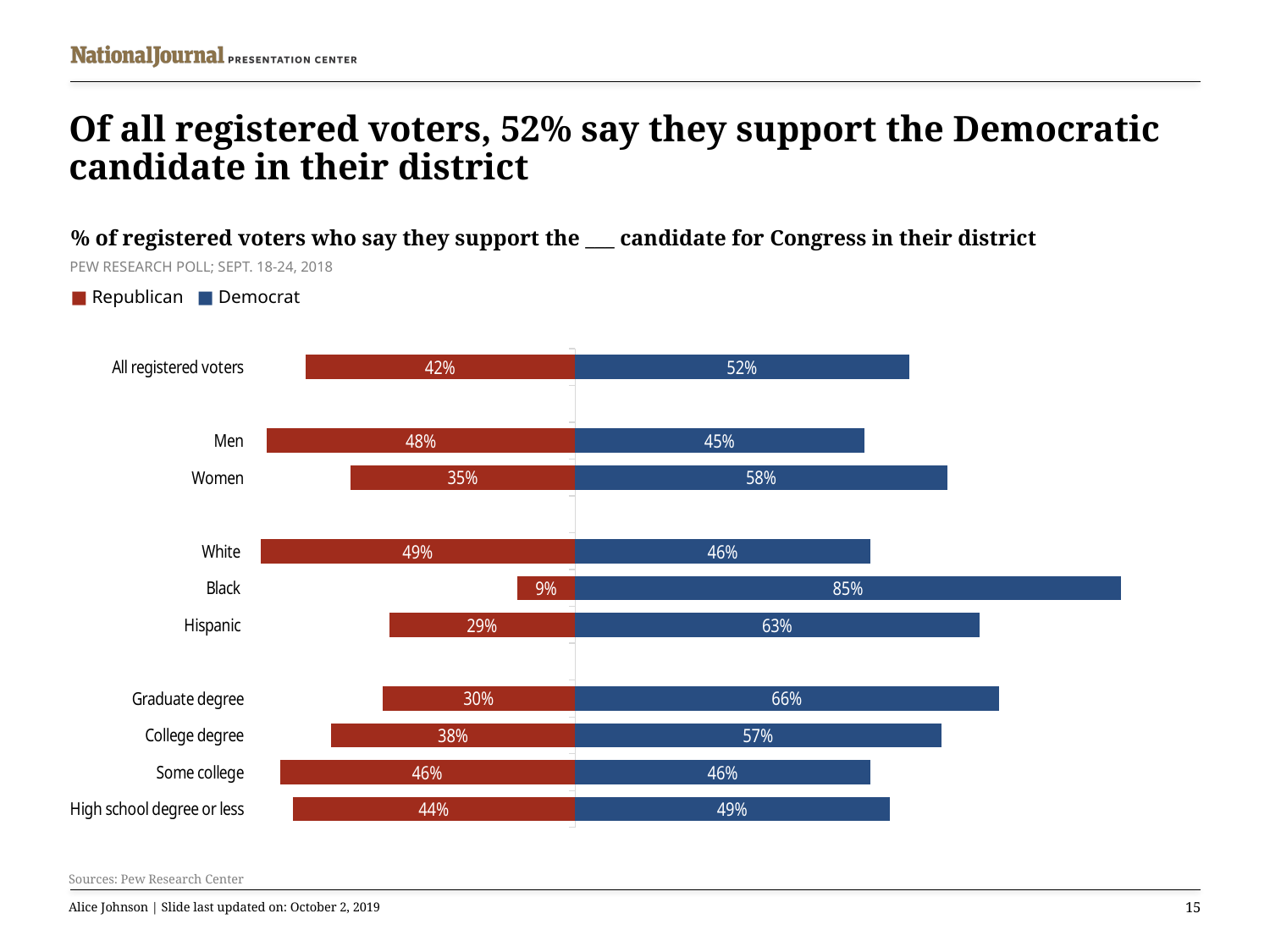
Which category has the lowest Republican value? Black Which colour represents the Democrat series in the legend? Blue What percentage of Women say they support the Republican candidate? 35% How many series does the legend list? 2 What kind of chart is shown on the slide? Bar chart For Men, which is larger: the Republican value or the Democrat value? Republican What is the Democrat value for voters with a Graduate degree? 66% Which category has the highest Republican value? White What is the difference between the Democrat and Republican values for Hispanic voters? 34 percentage points What percentage of Black registered voters say they support the Democratic candidate? 85% How many categories are shown on the chart? 10 Which category has the highest Democrat value? Black